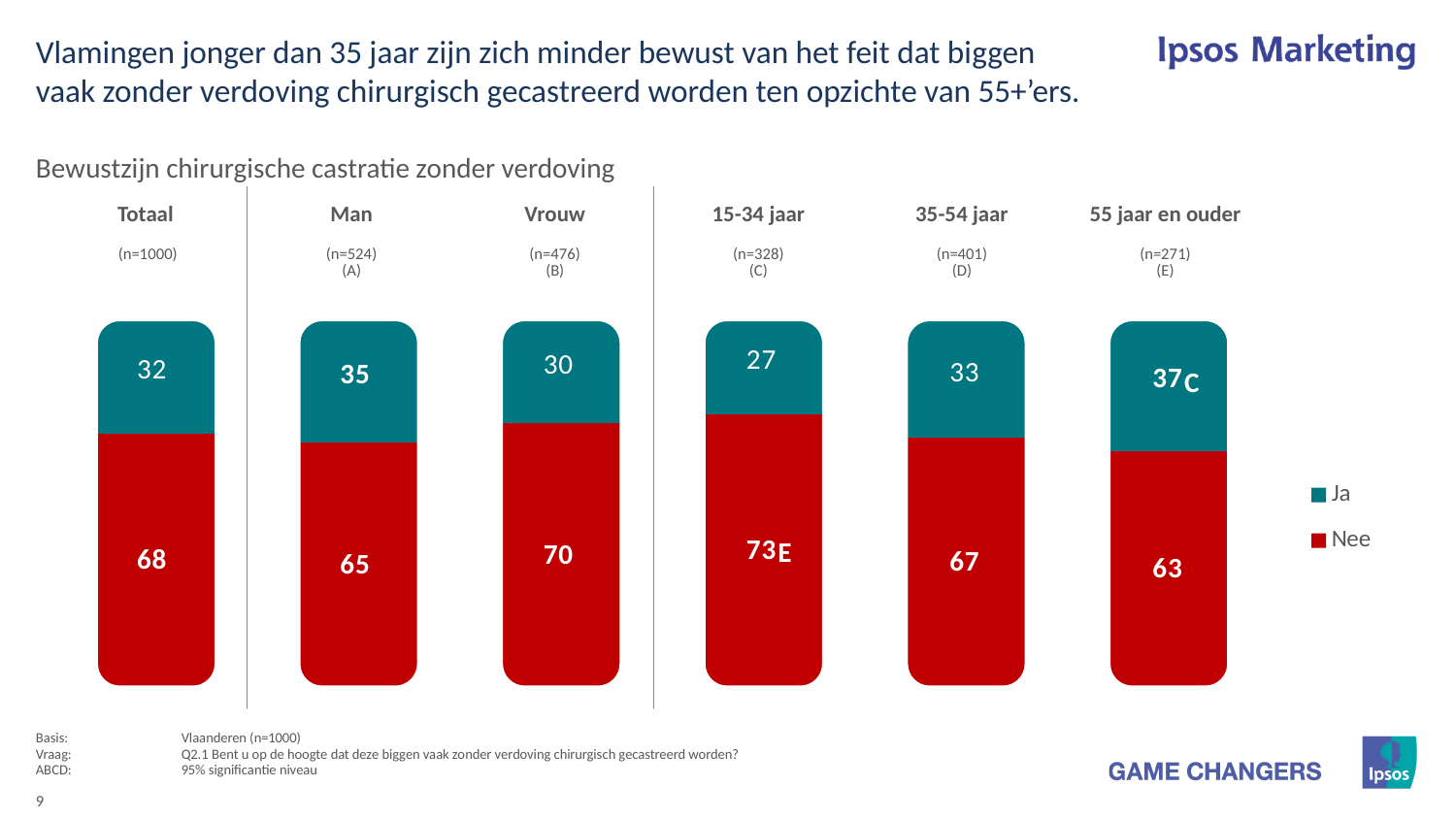
What is the value for 'Nee' in the Man category? 65 How many categories (bars) are shown in the chart? 6 What kind of chart is shown on the slide? Stacked bar chart What is the value for 'Ja' in the Vrouw category? 30 What is the value for 'Ja' in the Totaal category? 32 Which is larger, the 'Ja' value for Man or the 'Ja' value for Vrouw? Man What is the value for 'Nee' in the 35-54 jaar category? 67 What is the total of the stacked bar for the Totaal category? 100 Which category has the lowest value for 'Ja'? 15-34 jaar What is the difference between the 'Nee' values for Vrouw and Man? 5 Which category has the highest value for 'Ja'? 55 jaar en ouder How many series does the legend list? 2